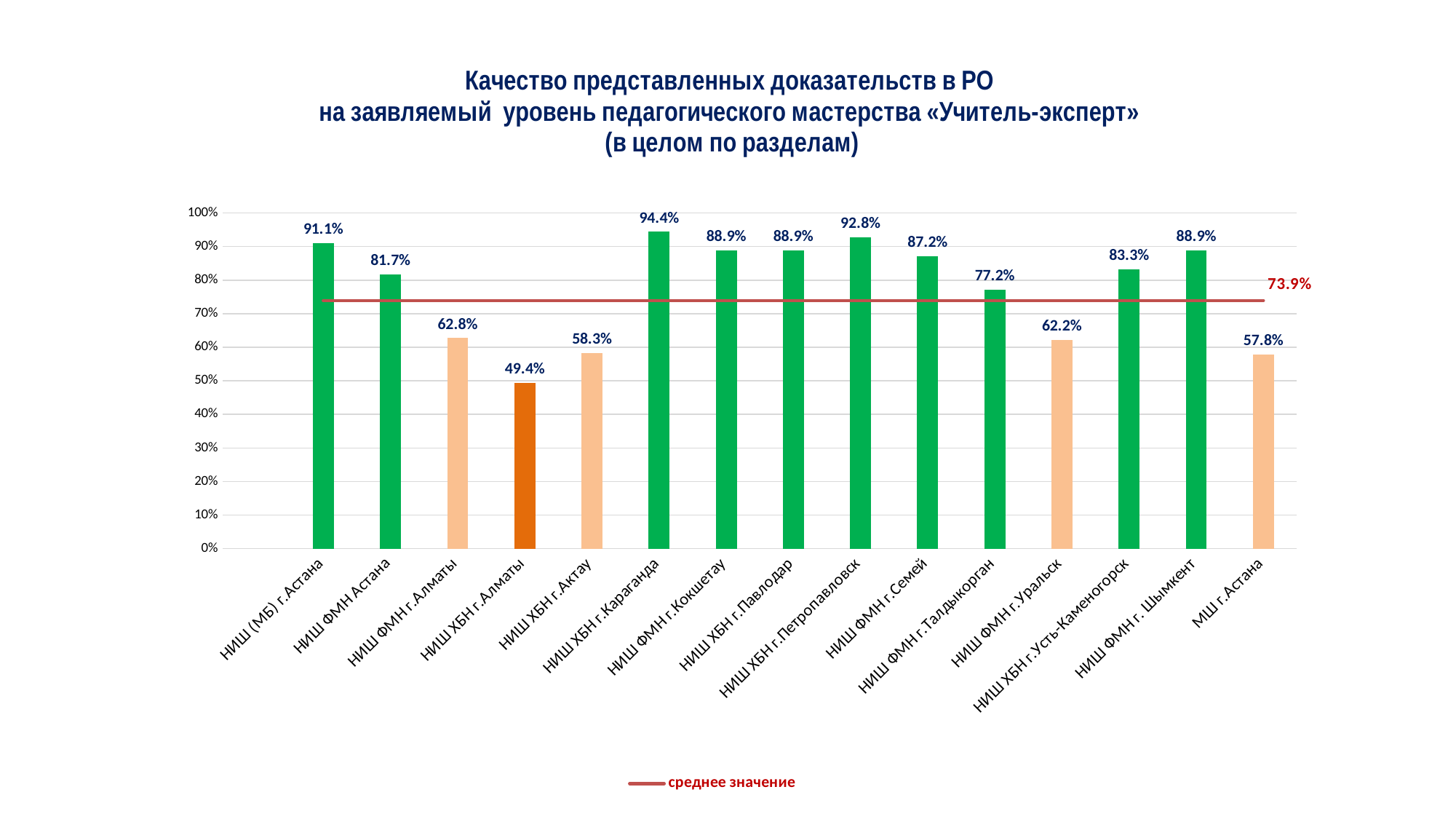
How many categories are shown on the x axis? 15 Is the value for НИШ ФМН г.Талдыкорган greater or less than 70%? greater Which is larger, the value for НИШ ХБН г.Петропавловск or the value for НИШ ФМН г.Семей? НИШ ХБН г.Петропавловск What is the value for МШ г.Астана? 57.8% What is the difference between the values for НИШ (МБ) г.Астана and НИШ ФМН Астана? 9.4% Which category has the highest value? НИШ ХБН г.Караганда What colour is the bar for НИШ ХБН г.Алматы? orange What is the value for НИШ ХБН г.Караганда? 94.4% Which category has the lowest value? НИШ ХБН г.Алматы What kind of chart is shown on the slide? bar chart What is the value for НИШ ФМН г.Уральск? 62.2% What value is shown for the red horizontal line labelled 'среднее значение'? 73.9%